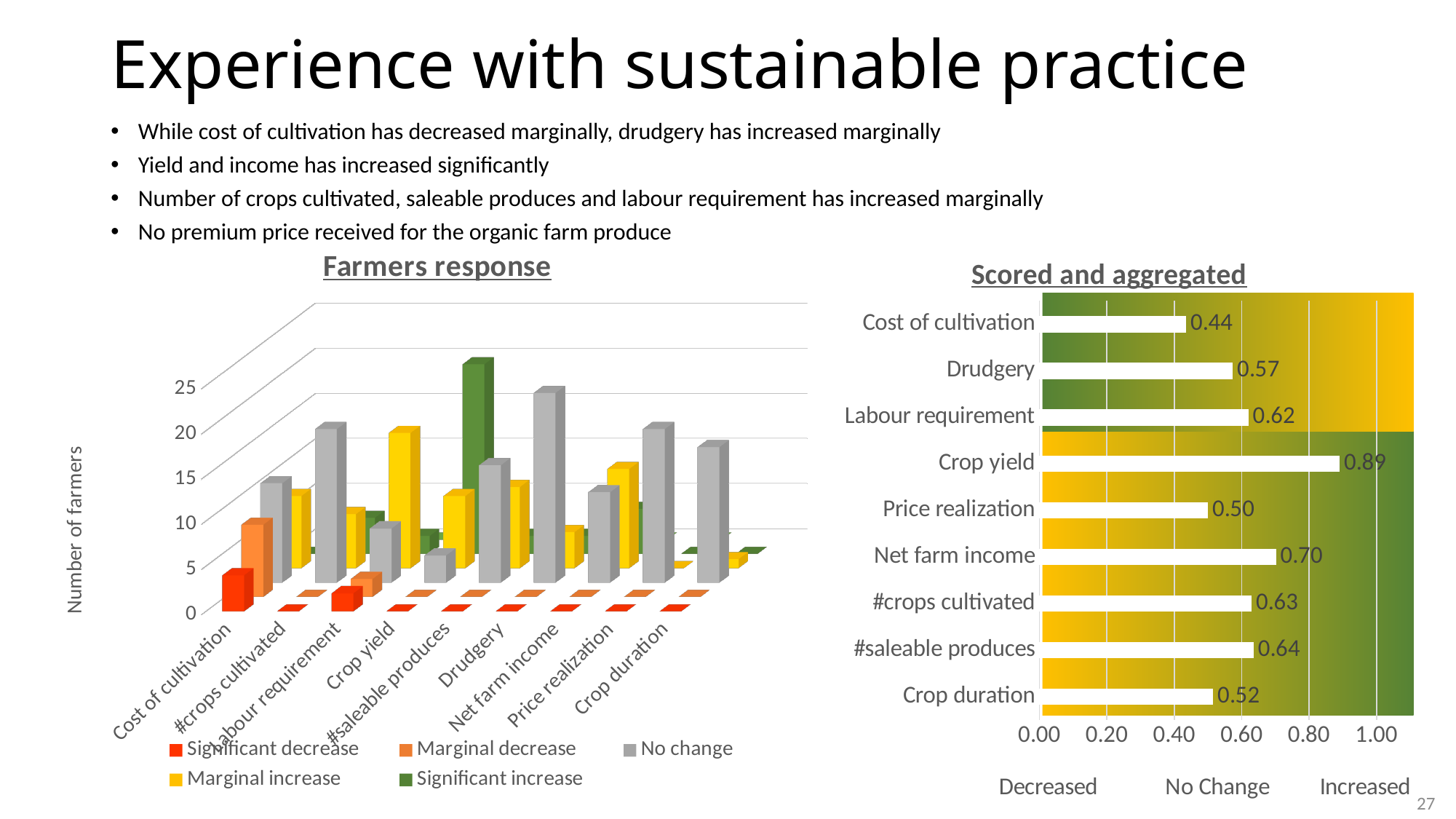
In the 'Scored and aggregated' chart, which category has the highest value? Crop yield In the 'Scored and aggregated' chart, is the value for Price realization greater or less than 0.60? less In the 'Scored and aggregated' chart, which is larger: the value for Drudgery or the value for Labour requirement? Labour requirement How many series does the legend of the 'Farmers response' chart list? 5 In the 'Scored and aggregated' chart, what is the value for Crop duration? 0.52 How many categories are shown in the 'Scored and aggregated' chart? 9 What kind of chart is the 'Scored and aggregated' chart? Bar chart In the 'Scored and aggregated' chart, what is the difference between the values for Crop yield and Cost of cultivation? 0.45 What is the y-axis label of the 'Farmers response' chart? Number of farmers In the 'Scored and aggregated' chart, what is the value for Net farm income? 0.70 In the 'Scored and aggregated' chart, which category has the lowest value? Cost of cultivation In the 'Scored and aggregated' chart, what is the value for Crop yield? 0.89